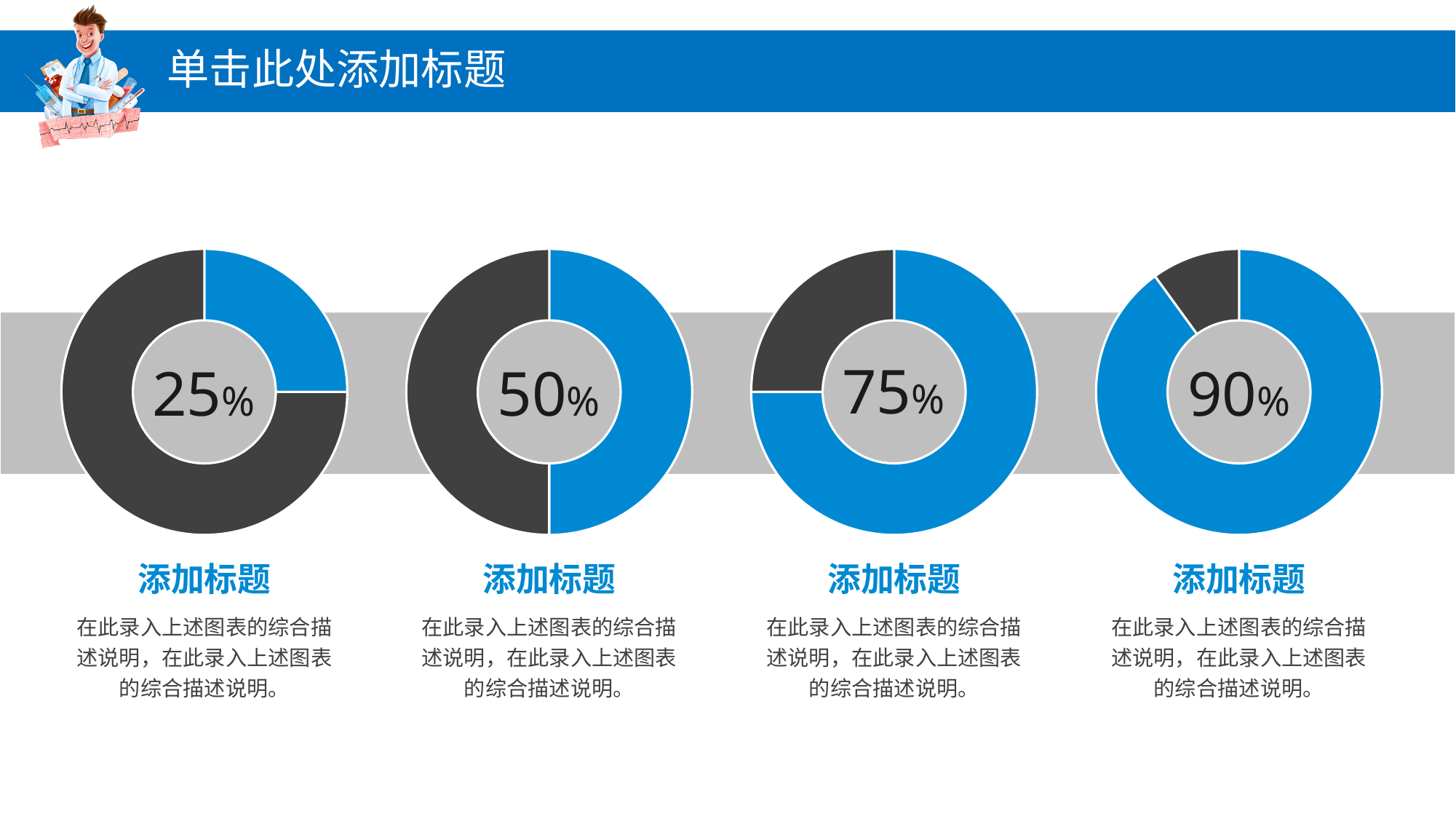
What value is shown in the centre of the leftmost donut chart? 25% Do the percentages rise or fall when reading the donut charts from left to right? rise How many donut charts are on the slide? 4 Which donut chart shows the highest percentage? the rightmost one (90%) Which is larger, the value in the second donut chart or the value in the third donut chart from the left? the third (75%) What is the difference between the value in the rightmost donut chart and the value in the leftmost donut chart? 65% Which donut chart shows the lowest percentage? the leftmost one (25%) What value is shown in the centre of the third donut chart from the left? 75% What value is shown in the centre of the rightmost donut chart? 90% What kind of chart is used on this slide? donut chart What is the difference between the values of the third and second donut charts from the left? 25% What value is shown in the centre of the second donut chart from the left? 50%